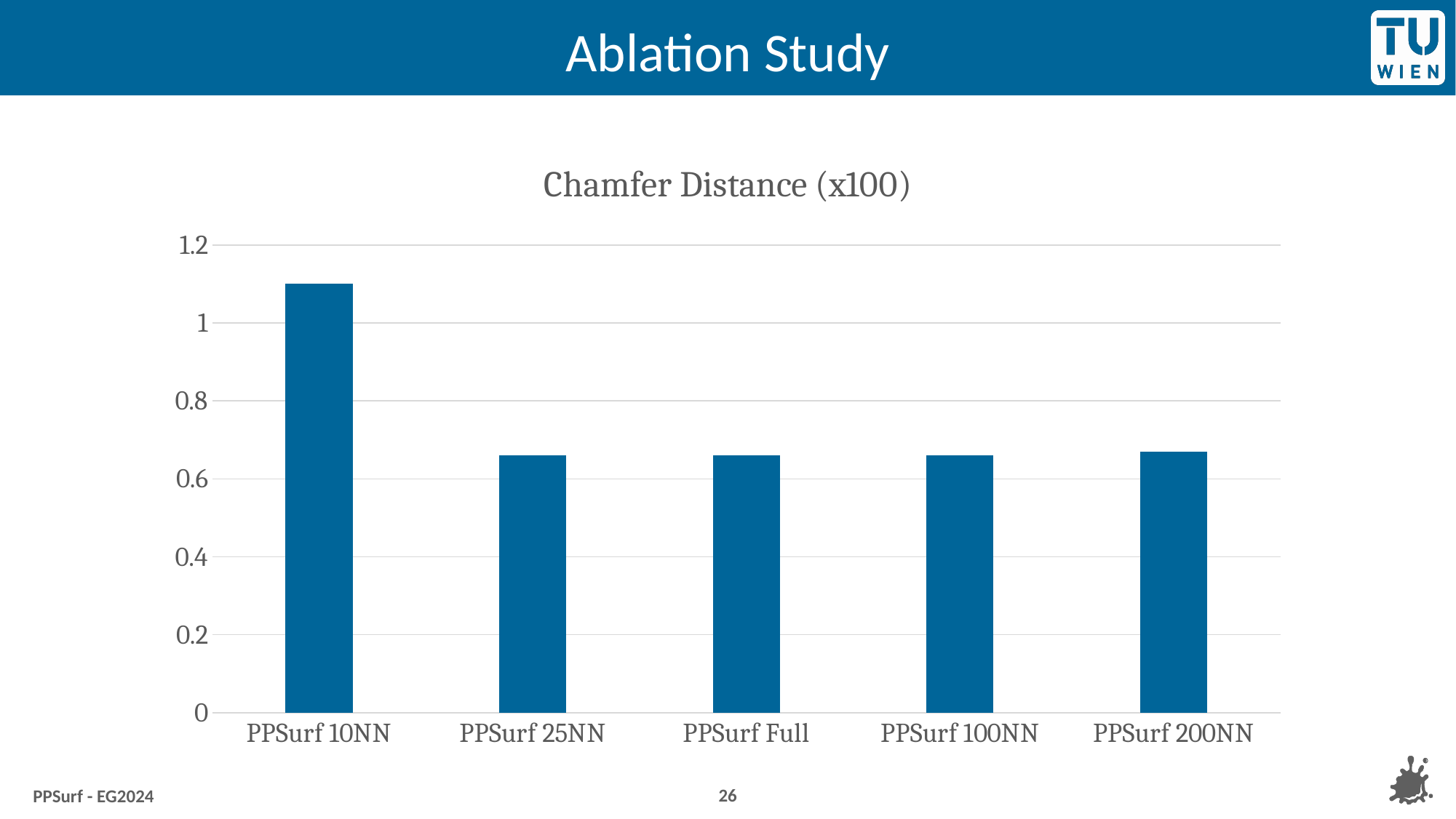
Which is larger, the value for PPSurf 10NN or the value for PPSurf Full? PPSurf 10NN Is the value for PPSurf 10NN greater or less than 1? greater What is the highest tick value shown on the vertical axis? 1.2 Is the value for PPSurf 10NN greater or less than 1.2? less How many categories are plotted in the chart? 5 Is the value for PPSurf Full greater or less than 0.6? greater What is the title of the chart? Chamfer Distance (x100) Which category has the highest Chamfer Distance? PPSurf 10NN What kind of chart is shown on the slide? bar chart